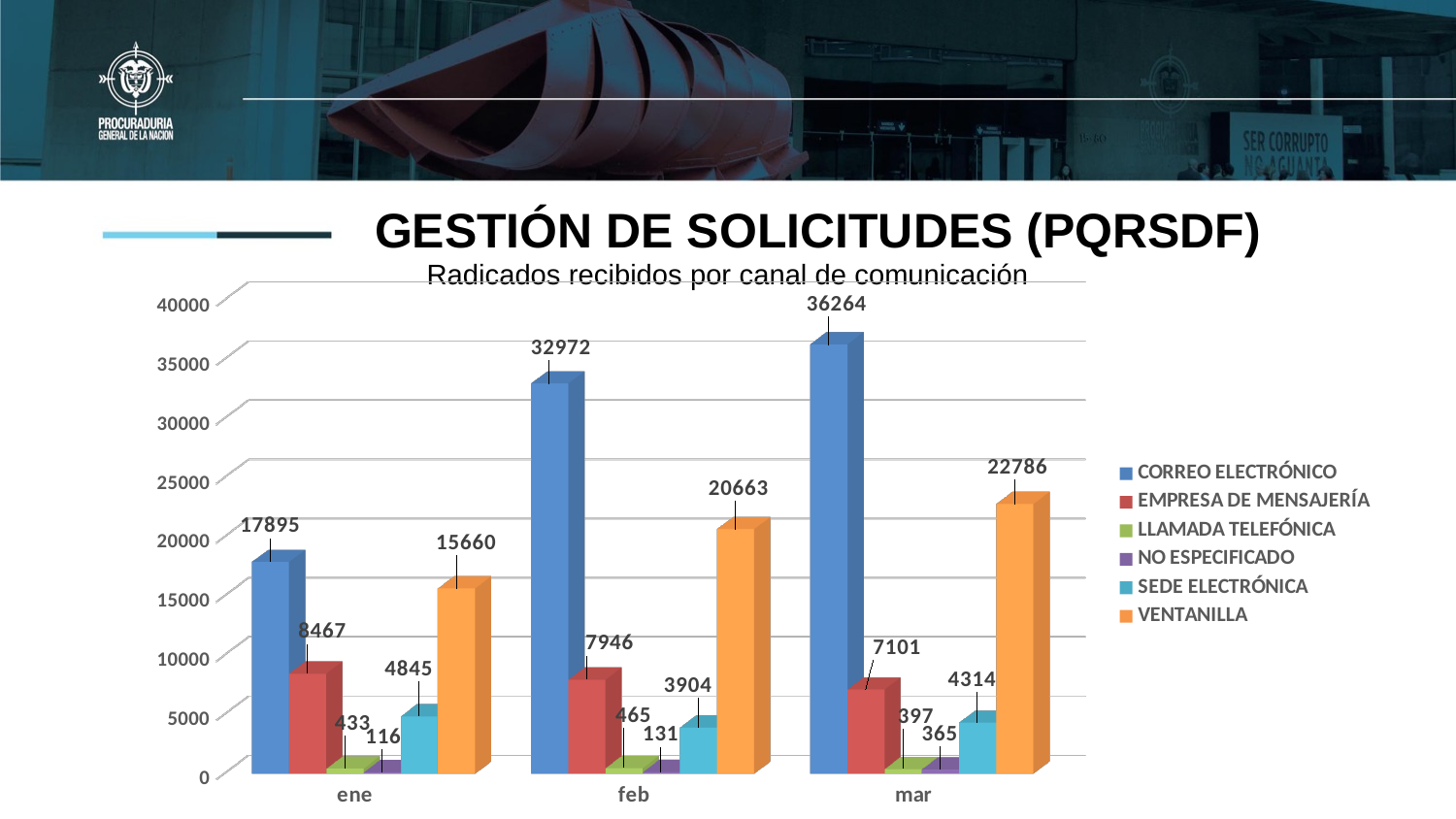
Which is larger: EMPRESA DE MENSAJERÍA in ene or in mar? ene How many series does the legend list? 6 What kind of chart is shown? bar chart What is the value for SEDE ELECTRÓNICA in ene? 4845 What is the value for CORREO ELECTRÓNICO in feb? 32972 What is the value for NO ESPECIFICADO in feb? 131 What is the difference between CORREO ELECTRÓNICO in mar and in feb? 3292 Does the value for VENTANILLA rise or fall from ene to mar? rise In which month is CORREO ELECTRÓNICO highest? mar What is the value for VENTANILLA in mar? 22786 How many months are shown on the x axis? 3 Which series has the lowest value in ene? NO ESPECIFICADO